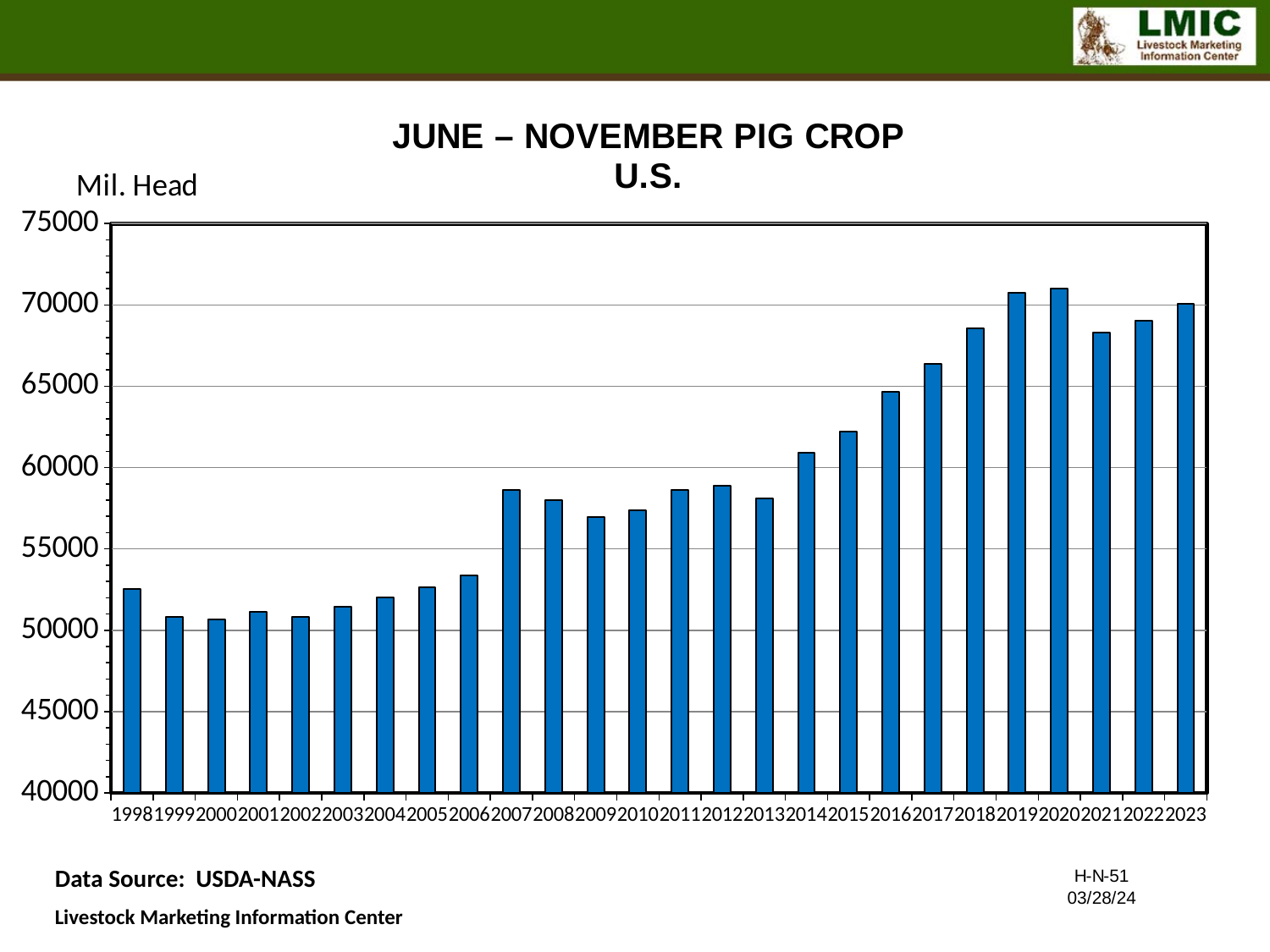
Which year has the larger value, 2020 or 2021? 2020 Overall, do the values rise or fall from 1998 to 2023? Rise Is the value for 2013 greater or less than 60000? less What is the title of the chart? JUNE – NOVEMBER PIG CROP U.S. Is the value for 2021 greater or less than 70000? less Is the value for 1998 greater or less than 50000? greater How many years (bars) are plotted in the chart? 26 Which year has the larger value, 2006 or 2007? 2007 What unit label is shown on the vertical axis of the chart? Mil. Head What kind of chart is shown on the slide? Bar chart